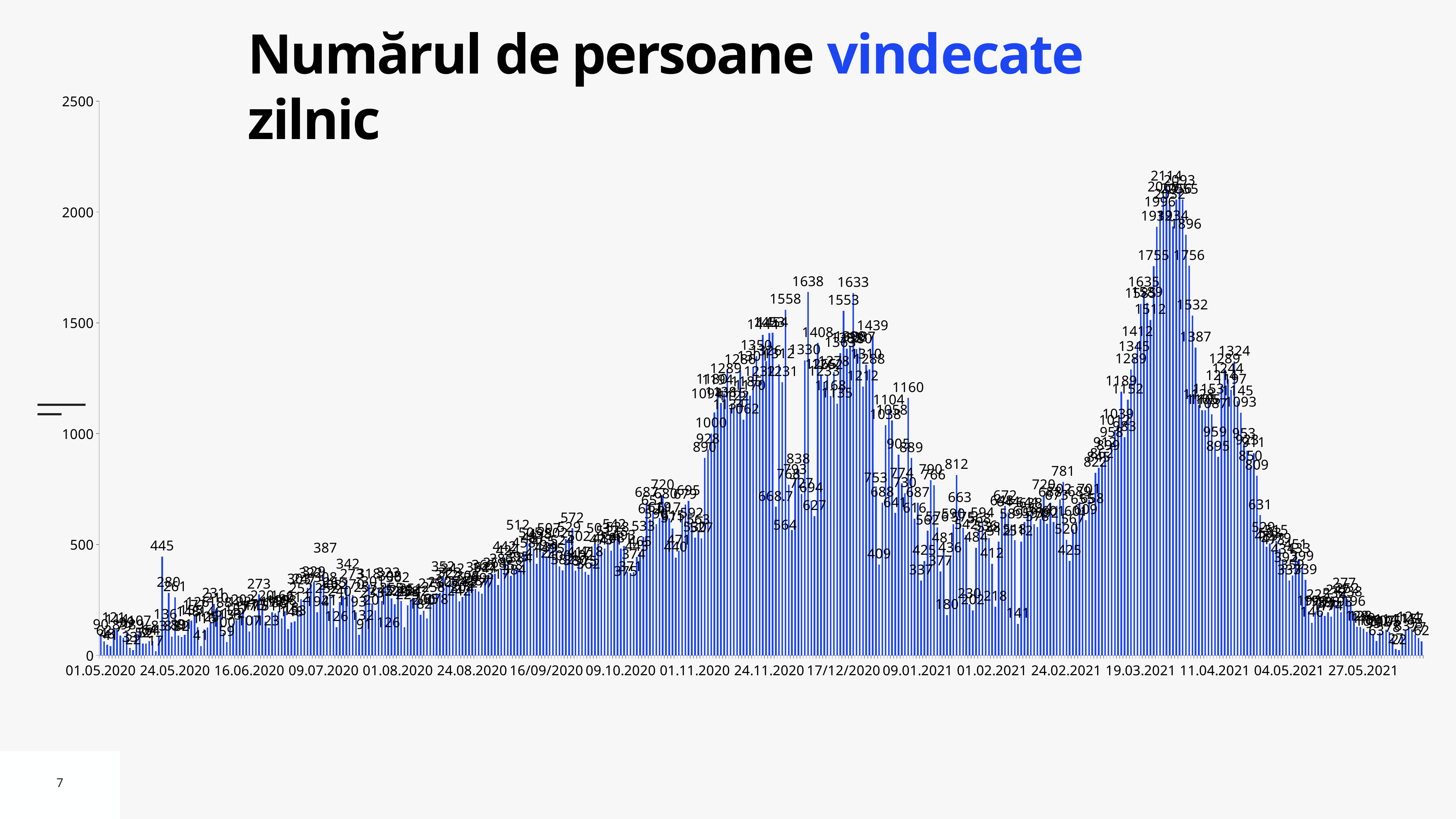
What kind of chart is shown on the slide? bar chart What is the difference between the peak labelled 2114 and the peak labelled 1638? 476 Do the values generally rise or fall between 01.05.2020 and 24.11.2020? rise How many date labels are printed along the horizontal axis? 18 What is the last date label on the horizontal axis? 27.05.2021 What is the highest data label printed on the chart? 2114 What is the highest value shown on the vertical axis? 2500 Do the values generally rise or fall between 11.04.2021 and 27.05.2021? fall What is the first date label on the horizontal axis? 01.05.2020 Is the value for the first bar at 01.05.2020 greater or less than 500? less Which is larger: the peak value around 11.04.2021 (2114) or the peak value around 24.11.2020 (1638)? 2114 What is the title of the chart? Numărul de persoane vindecate zilnic